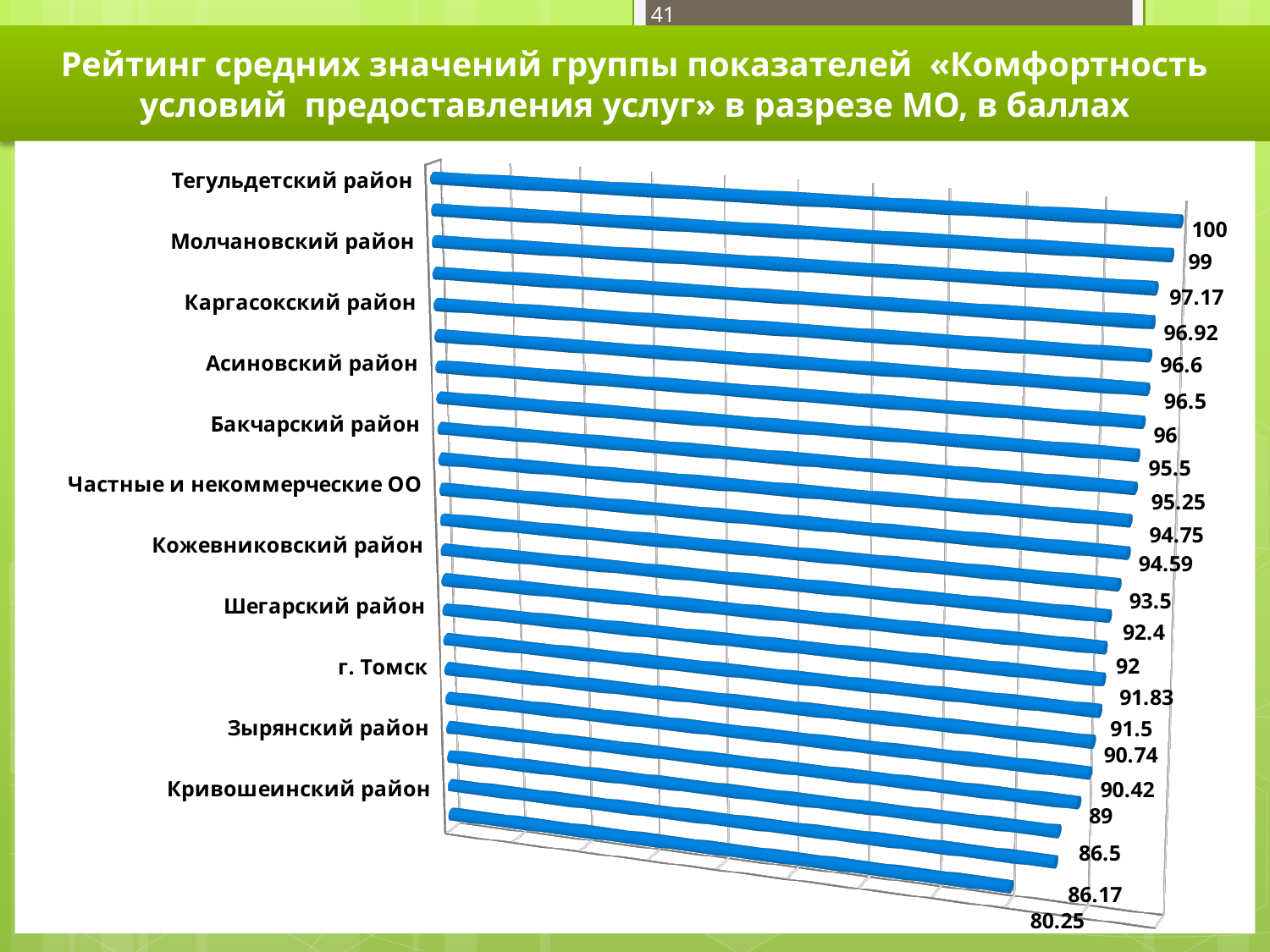
What is the difference between the highest value (100) and the lowest value (80.25)? 19.75 Which category has the highest value? Тегульдетский район Which is larger, the value for Тегульдетский район or the value for Кривошеинский район? Тегульдетский район What is the lowest value shown on the chart? 80.25 What is the value for Тегульдетский район? 100 What is the value for Кривошеинский район? 86.17 Do the values rise or fall going from the top bar to the bottom bar? fall What kind of chart is shown on the slide? bar chart What is the value for Молчановский район? 97.17 What is the highest value shown on the chart? 100 What is the value for г. Томск? 90.74 How many bars are plotted on the chart? 22